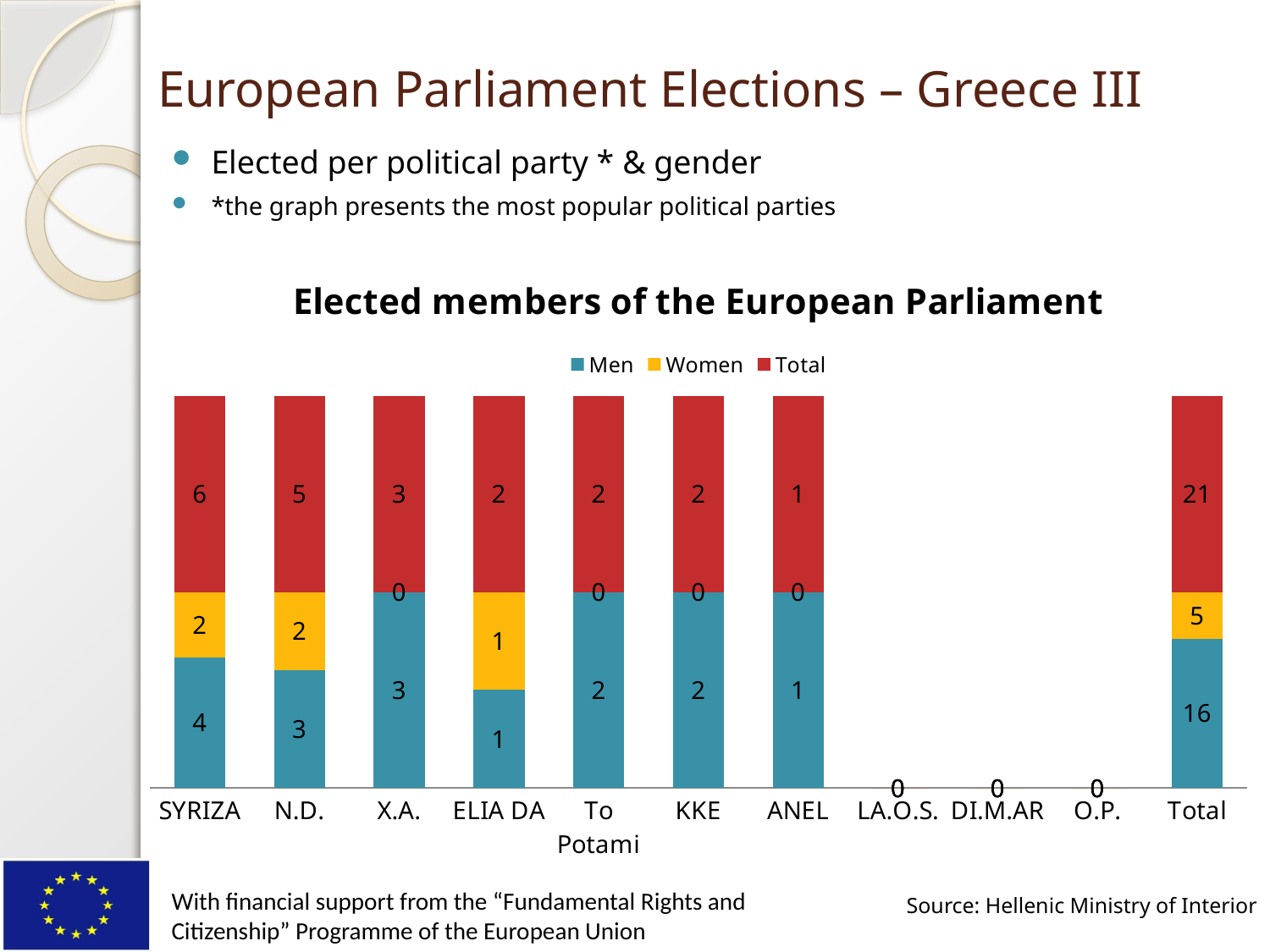
Which party has the highest Women value? SYRIZA and N.D. (tied at 2) What is the title of the chart? Elected members of the European Parliament What is the Total value for X.A.? 3 What is the Men value for the Total category? 16 Among the political parties (excluding the Total category), which party has the highest Total value? SYRIZA What is the Men value for SYRIZA? 4 How many series does the legend list? 3 What is the difference between the Men value for SYRIZA and the Men value for N.D.? 1 Which is larger, the Total value for N.D. or the Total value for ELIA DA? N.D. What is the Women value for N.D.? 2 What kind of chart is shown? Stacked bar chart How many categories are shown on the x axis? 11